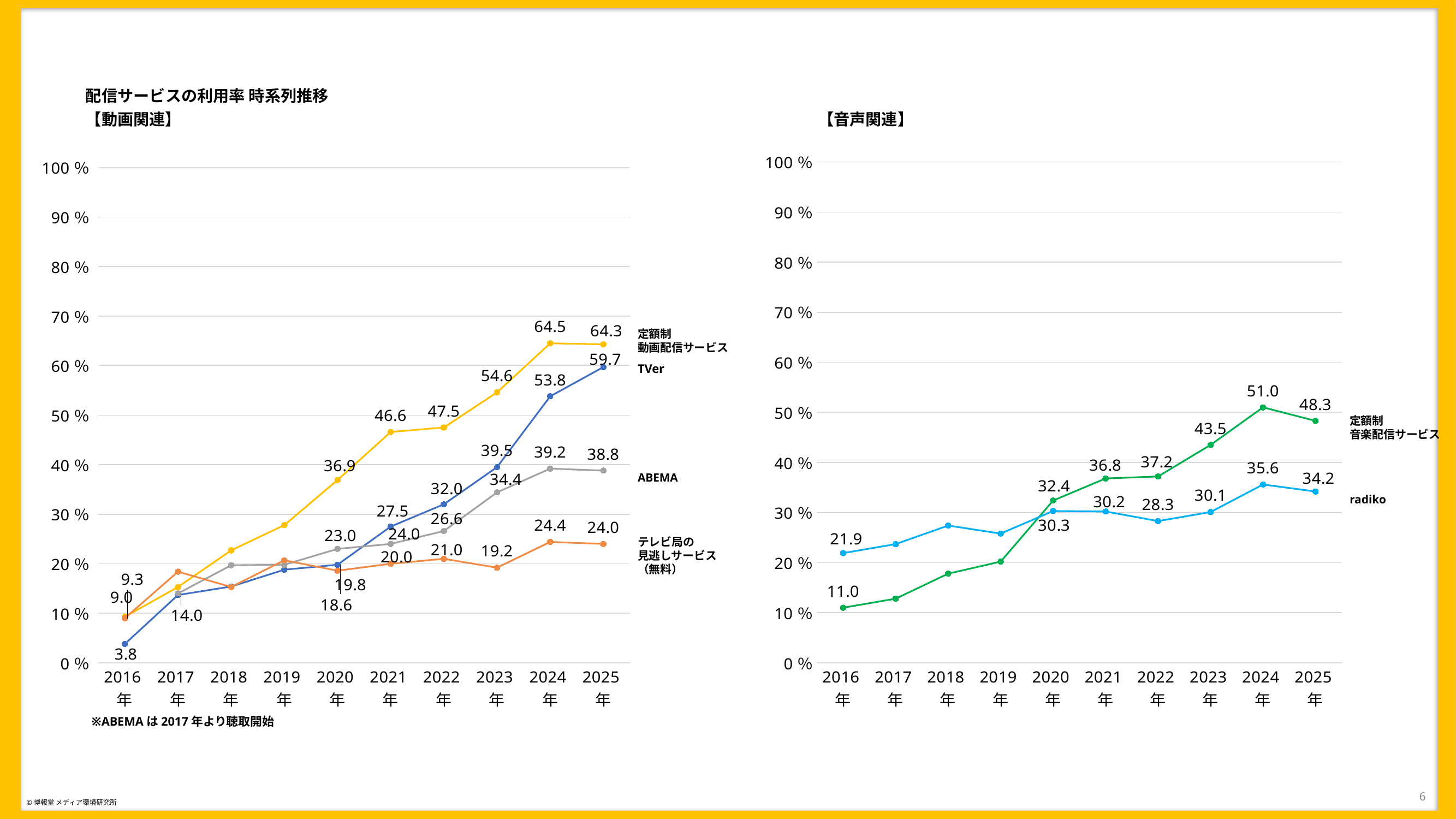
In the 【動画関連】 chart on the left, what is the value for ABEMA in 2023年? 34.4 In the 【動画関連】 chart on the left, does the TVer line rise or fall from 2016年 to 2025年? Rises What kind of chart is the 【音声関連】 chart on the right? Line chart In the 【音声関連】 chart on the right, what is the value for radiko in 2024年? 35.6 How many series are plotted in the 【動画関連】 chart on the left? 4 In the 【音声関連】 chart on the right, what is the difference between 定額制音楽配信サービス and radiko in 2025年? 14.1 In the 【動画関連】 chart on the left, what is the value for TVer in 2025年? 59.7 In the 【音声関連】 chart on the right, in which year does 定額制音楽配信サービス reach its highest value? 2024年 How many years are shown on the x axis of the 【音声関連】 chart on the right? 10 In the 【動画関連】 chart on the left, is the value for 定額制動画配信サービス in 2019年 greater or less than 30%? less In the 【動画関連】 chart on the left, which is larger in 2024年: TVer or ABEMA? TVer In the 【動画関連】 chart on the left, what is the value for 定額制動画配信サービス in 2024年? 64.5